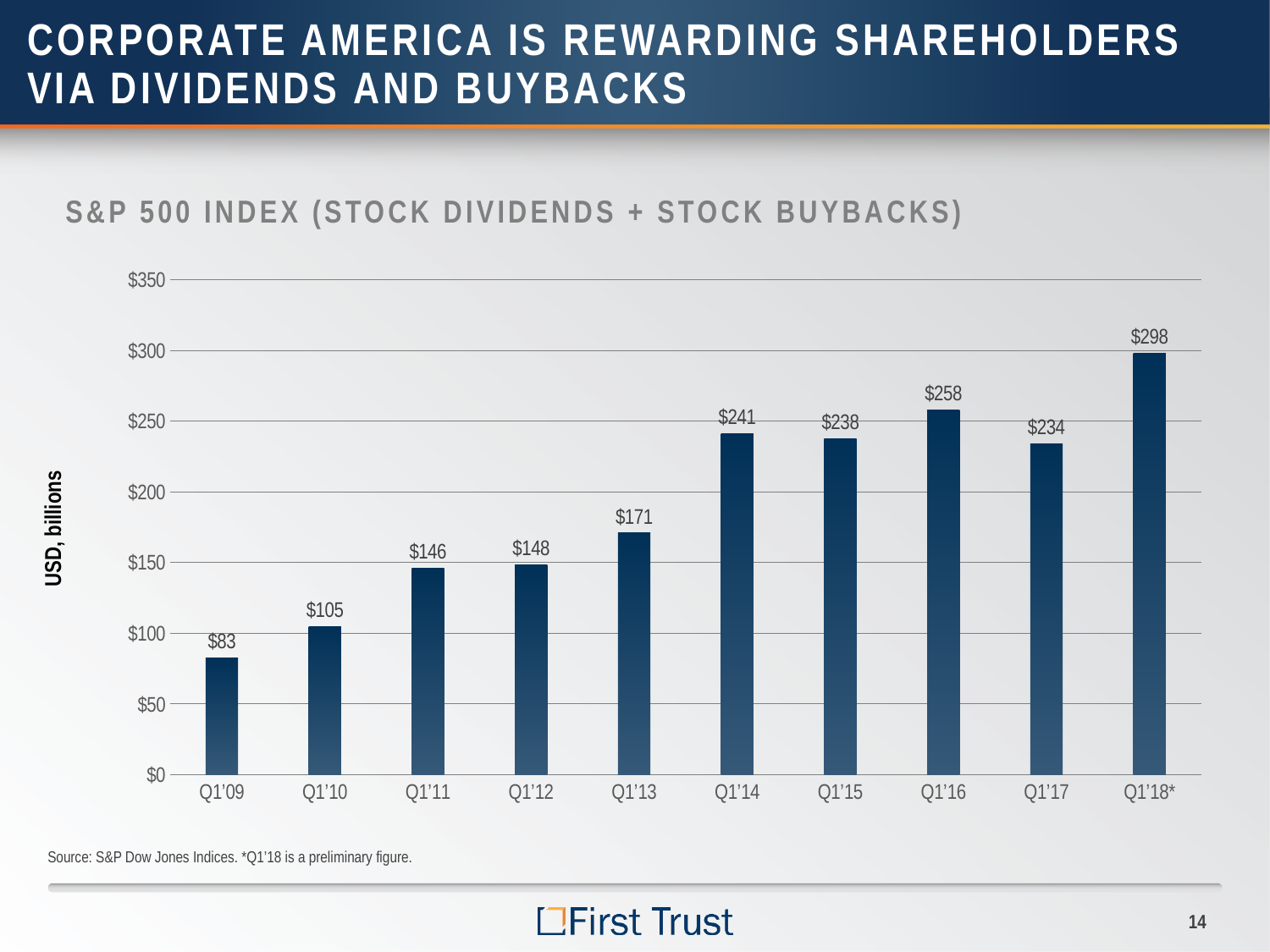
What is the difference between the values for Q1'18* and Q1'17? $64 What is the label on the y axis? USD, billions What is the value for Q1'16? $258 Is the value for Q1'12 greater or less than $150? less What is the value for Q1'09? $83 Which quarter has the lowest value? Q1'09 Which is larger, the value for Q1'14 or the value for Q1'15? Q1'14 How many quarters are shown on the x axis? 10 What kind of chart is shown on the slide? bar chart What is the value for Q1'13? $171 Which quarter has the highest value? Q1'18* What is the difference between the values for Q1'10 and Q1'09? $22